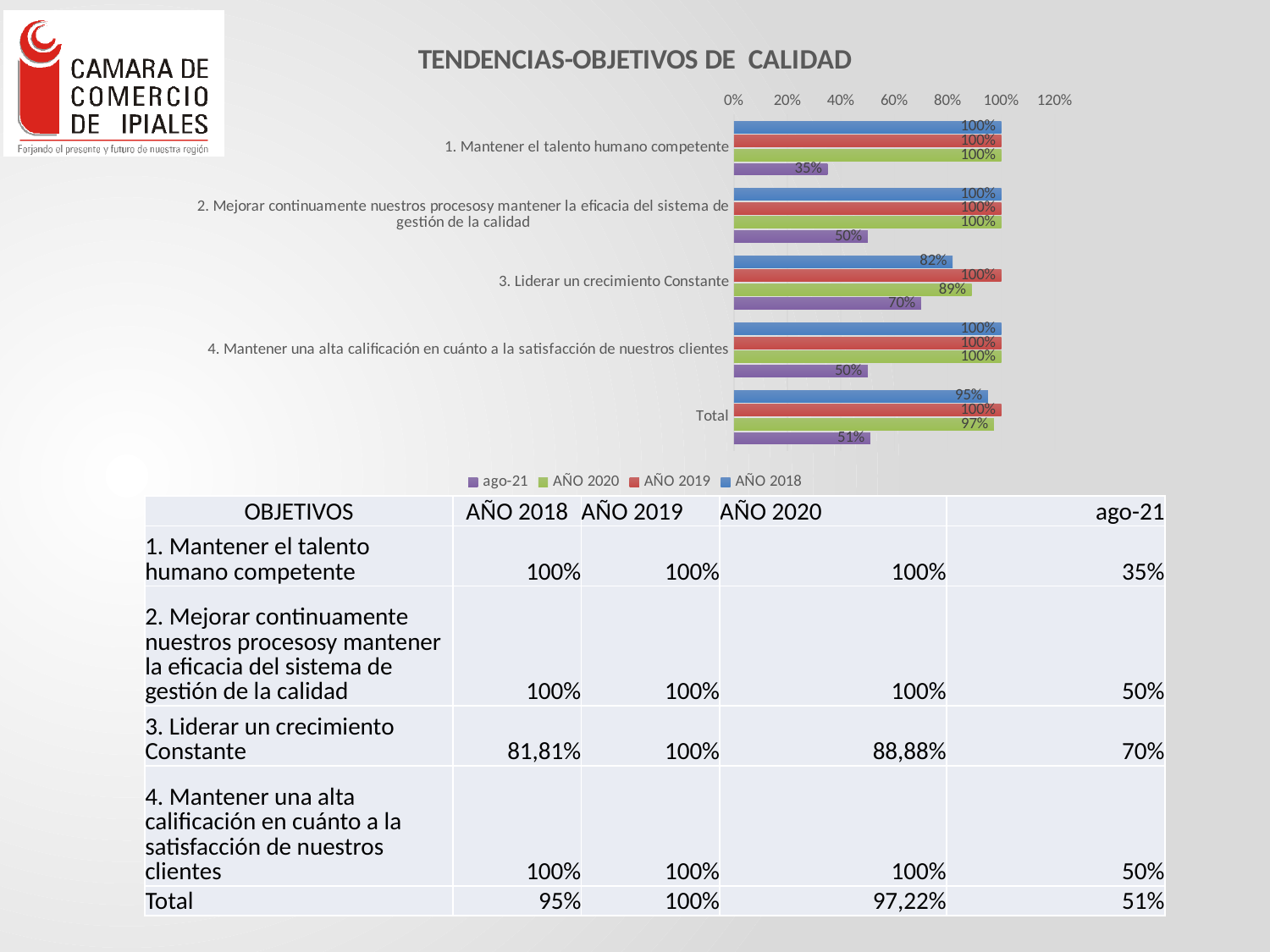
What is the ago-21 value for "1. Mantener el talento humano competente"? 35% How many series does the chart legend list? 4 Which category has the lowest ago-21 value? 1. Mantener el talento humano competente Which category has the highest ago-21 value? 3. Liderar un crecimiento Constante How many categories are plotted on the chart? 5 What is the difference between the AÑO 2019 and ago-21 values for "3. Liderar un crecimiento Constante"? 30% What is the AÑO 2018 value for "3. Liderar un crecimiento Constante"? 82% What is the ago-21 value for "Total"? 51% Which is larger for "Total": the AÑO 2020 value or the AÑO 2018 value? AÑO 2020 What type of chart is shown on the slide? bar chart What is the AÑO 2018 value for "Total"? 95% What is the AÑO 2020 value for "3. Liderar un crecimiento Constante"? 89%